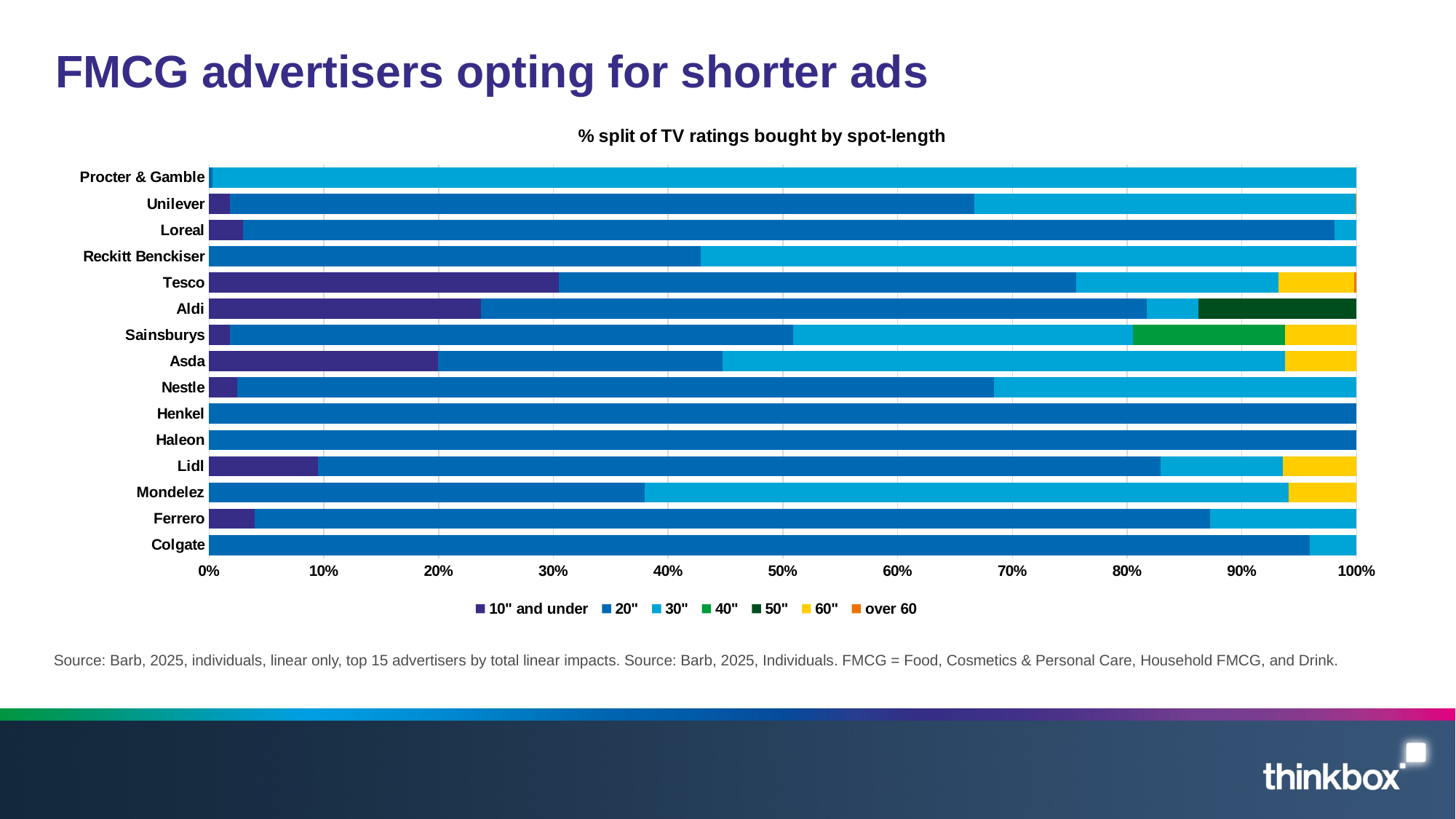
Which advertiser has the largest share of ratings bought in 10" and under spots? Tesco How many advertisers are listed on the chart? 15 What kind of chart is shown on the slide? Stacked bar chart Which advertiser is the only one with a 40" segment? Sainsburys Is Mondelez's share of 20" spots greater or less than 40%? less Which advertiser has the larger share of 20" spots, Unilever or Reckitt Benckiser? Unilever How many spot-length series does the legend list? 7 What is the title of the chart? % split of TV ratings bought by spot-length Is Aldi's share of 10" and under spots greater or less than 20%? greater Which advertiser is the only one with a 50" segment? Aldi Is Colgate's share of 20" spots greater or less than 90%? greater